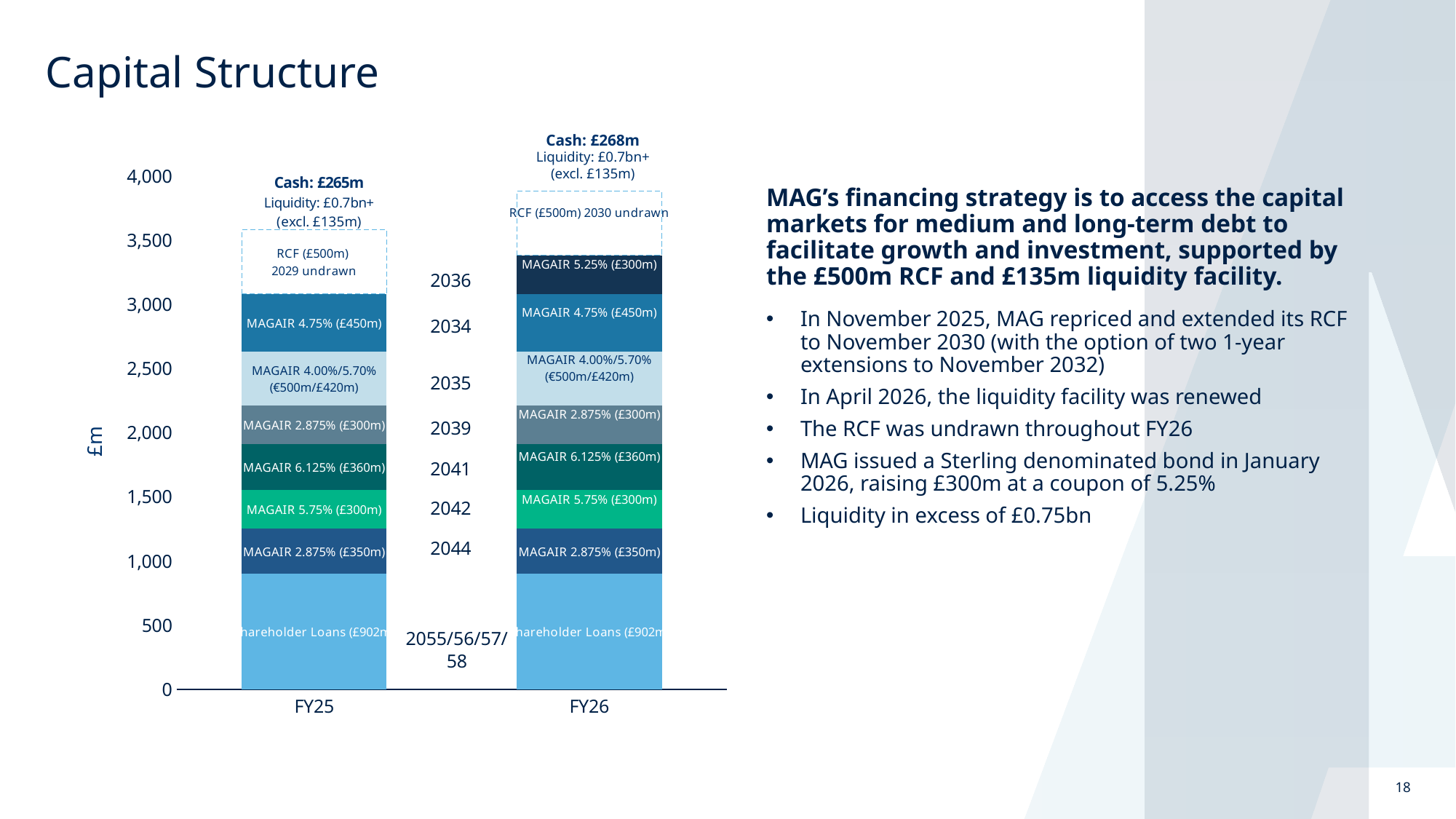
What is the cash figure shown above the FY25 bar? £265m Which bar is taller overall, FY25 or FY26? FY26 What is the difference between the FY26 cash figure and the FY25 cash figure? £3m What is the cash figure shown above the FY26 bar? £268m Which year has the higher cash figure, FY25 or FY26? FY26 What kind of chart is shown on the slide? Stacked bar chart What is the value of the Shareholder Loans segment in the FY25 bar? £902m Which bond segment appears in the FY26 bar but not in the FY25 bar? MAGAIR 5.25% (£300m) What is the label on the vertical axis of the chart? £m What is the value of the MAGAIR 4.75% bond segment? £450m How many financial years (bars) are shown on the chart? 2 In which year is the RCF in the FY26 bar shown as maturing? 2030